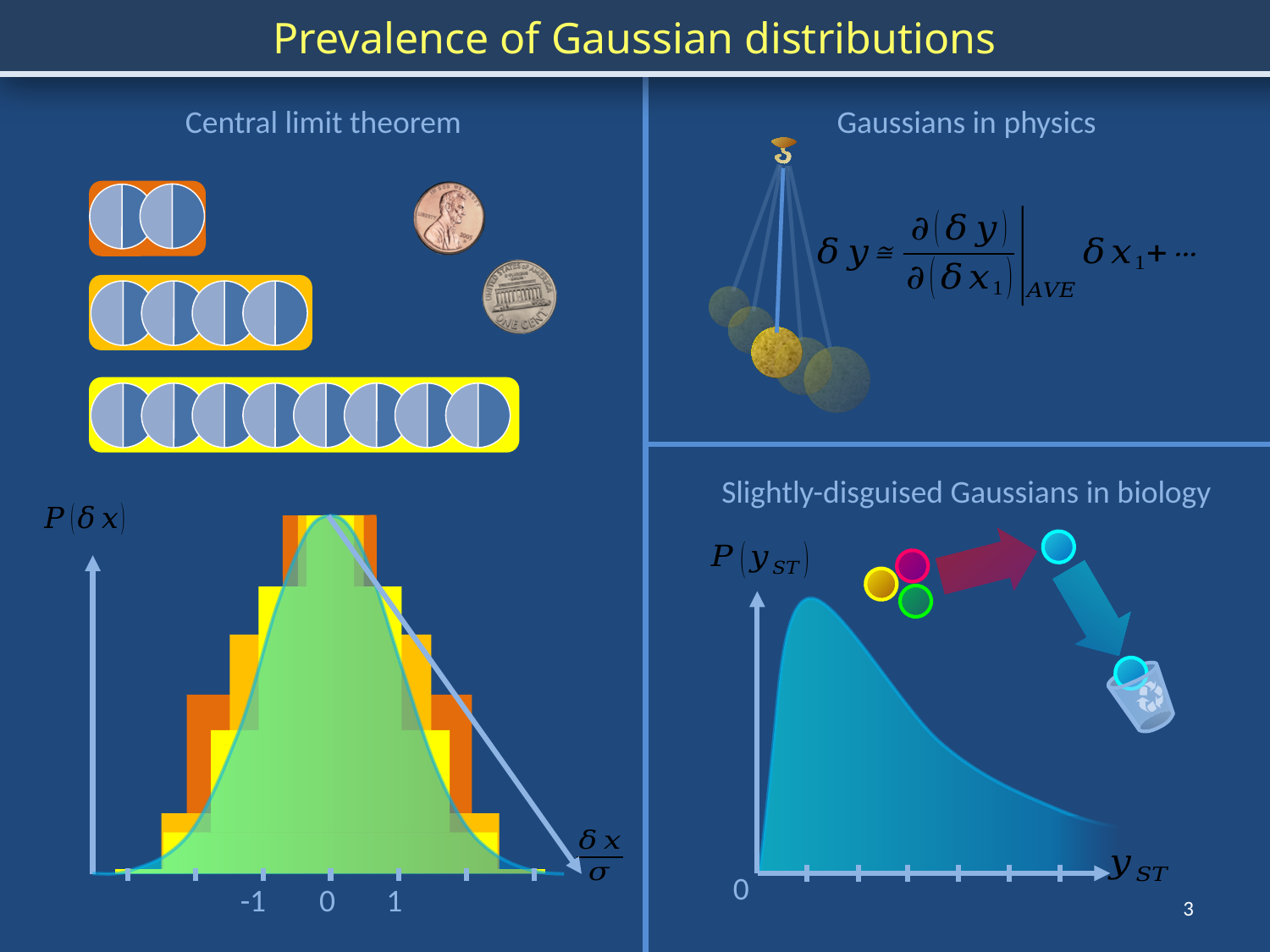
In the chart under 'Slightly-disguised Gaussians in biology', is the peak of the curve closer to the left end or the right end of the horizontal axis? left end In the chart under 'Central limit theorem', is the value at x = 1 larger or smaller than the value at x = 0? smaller In the chart under 'Slightly-disguised Gaussians in biology', how does the curve change after its peak as y_ST increases? it falls In the chart under 'Central limit theorem', what tick labels are printed on the x axis? -1, 0, 1 In the chart under 'Central limit theorem', is the value at x = -1 larger or smaller than the value at x = 0? smaller In the chart under 'Central limit theorem', at which x-axis tick label does the distribution reach its peak? 0 In the chart under 'Central limit theorem', what kind of chart is shown? histogram with a curve overlay In the chart under 'Central limit theorem', how many labelled ticks are on the x axis? 3 In the chart under 'Slightly-disguised Gaussians in biology', what is the only tick label printed on the horizontal axis? 0 In the chart under 'Central limit theorem', what is the label on the vertical axis? P(δx) In the chart under 'Central limit theorem', how do the values change as x increases from 0 to the right end of the axis? they fall In the chart under 'Slightly-disguised Gaussians in biology', what is the label on the horizontal axis? y_ST